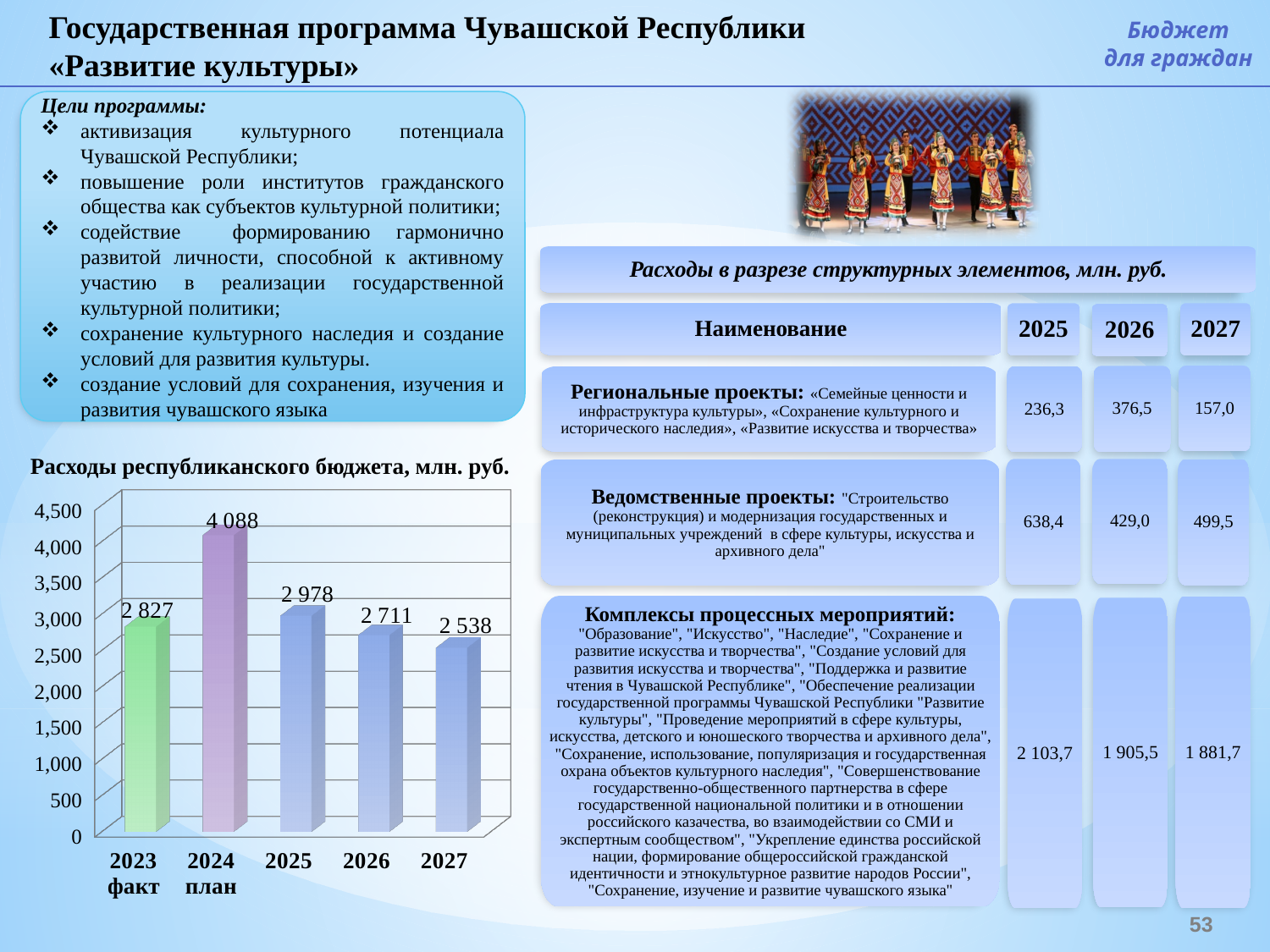
In the chart 'Расходы республиканского бюджета, млн. руб.', which is larger: the value for 2025 or the value for 2023 факт? 2025 Which year has the lowest value in the chart 'Расходы республиканского бюджета, млн. руб.'? 2027 What is the difference between the 2024 план and 2025 values in the chart 'Расходы республиканского бюджета, млн. руб.'? 1 110 What is the value for 2024 план in the chart 'Расходы республиканского бюджета, млн. руб.'? 4 088 What is the value for 2027 in the chart 'Расходы республиканского бюджета, млн. руб.'? 2 538 Which year has the highest value in the chart 'Расходы республиканского бюджета, млн. руб.'? 2024 план In the chart 'Расходы республиканского бюджета, млн. руб.', do the values rise or fall from 2025 to 2027? fall What is the difference between the 2026 and 2027 values in the chart 'Расходы республиканского бюджета, млн. руб.'? 173 What kind of chart is 'Расходы республиканского бюджета, млн. руб.'? bar chart What is the value for 2023 факт in the chart 'Расходы республиканского бюджета, млн. руб.'? 2 827 How many bars are shown in the chart 'Расходы республиканского бюджета, млн. руб.'? 5 In the chart 'Расходы республиканского бюджета, млн. руб.', is the value for 2024 план greater or less than 4,000? greater